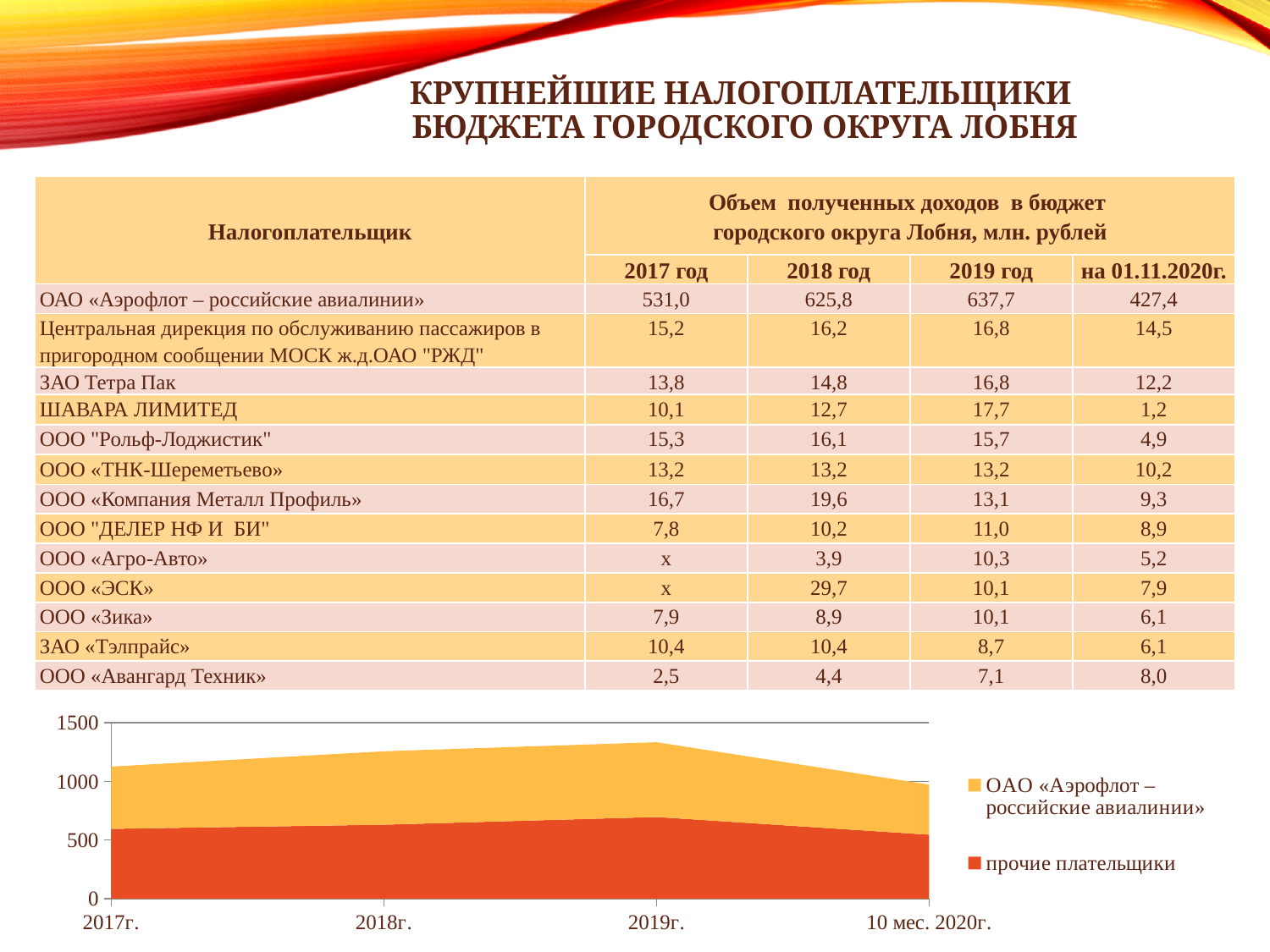
In the area chart, which period has the highest stacked total? 2019г. How many periods are plotted along the x axis of the area chart? 4 In the area chart, is the value for прочие плательщики in 2019г. greater or less than 500? greater What kind of chart is shown at the bottom of the slide? stacked area chart In the area chart, is the value for прочие плательщики in 2017г. greater or less than 500? greater How many series does the legend of the area chart list? 2 Which series is shown in yellow-orange in the area chart? ОАО «Аэрофлот – российские авиалинии» In the area chart, does the stacked total rise or fall from 2017г. to 2019г.? rise Which series is shown in red in the area chart? прочие плательщики In the area chart, is the stacked total for 2017г. greater or less than 1500? less In the area chart, which period has the lowest stacked total? 10 мес. 2020г.